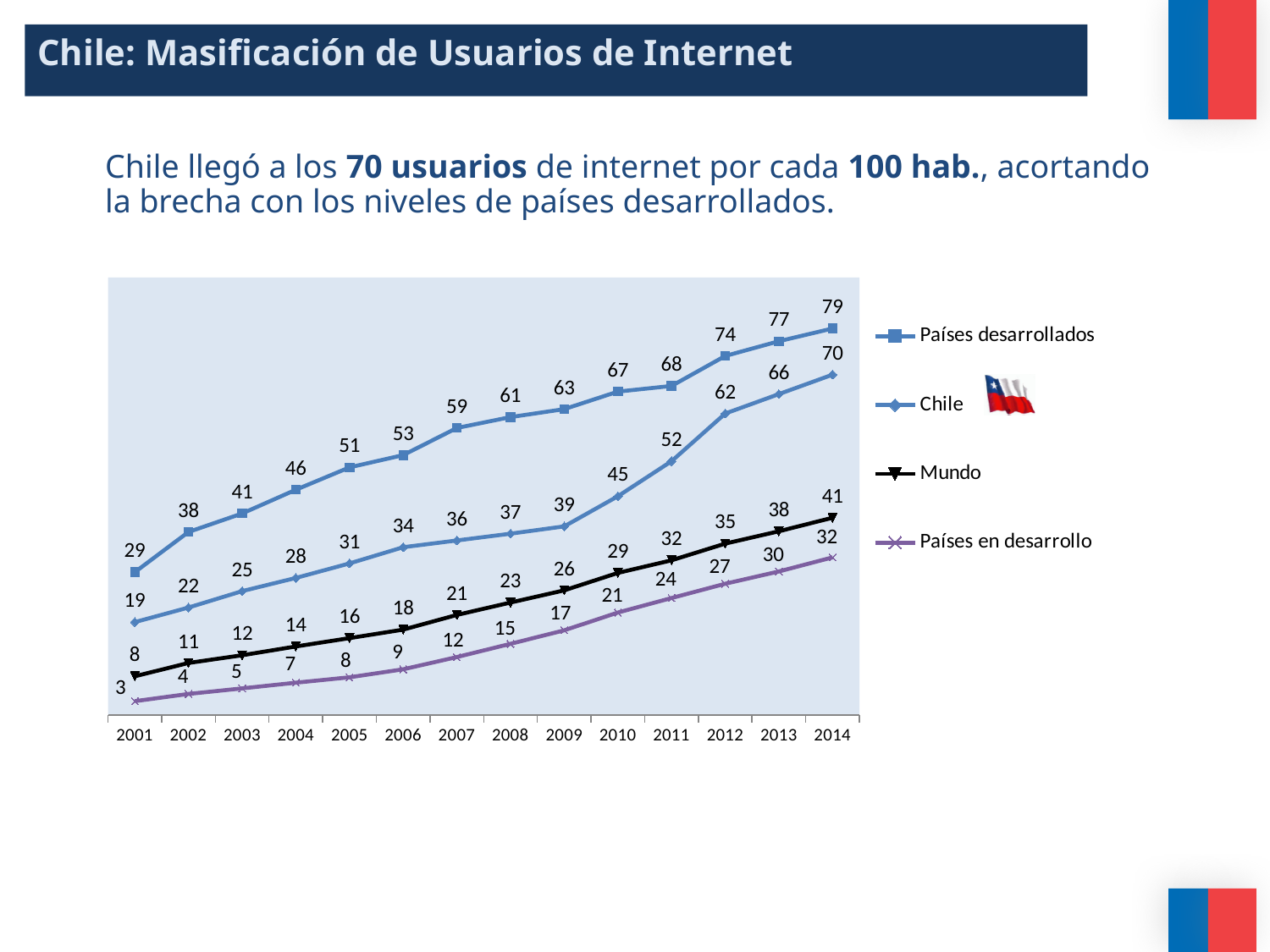
Which is larger in 2012, the value for Chile or the value for Mundo? Chile How many series does the legend list? 4 What is the value for Países en desarrollo in 2001? 3 What is the value for Mundo in 2010? 29 How many years are plotted along the x axis? 14 What type of chart is shown on the slide? line chart In which year is the value for Chile highest? 2014 In which year is the value for Países desarrollados lowest? 2001 What is the value for Países desarrollados in 2007? 59 What is the value for Chile in 2014? 70 Does the value for Chile rise or fall from 2001 to 2014? rise What is the difference between Países desarrollados and Chile in 2014? 9